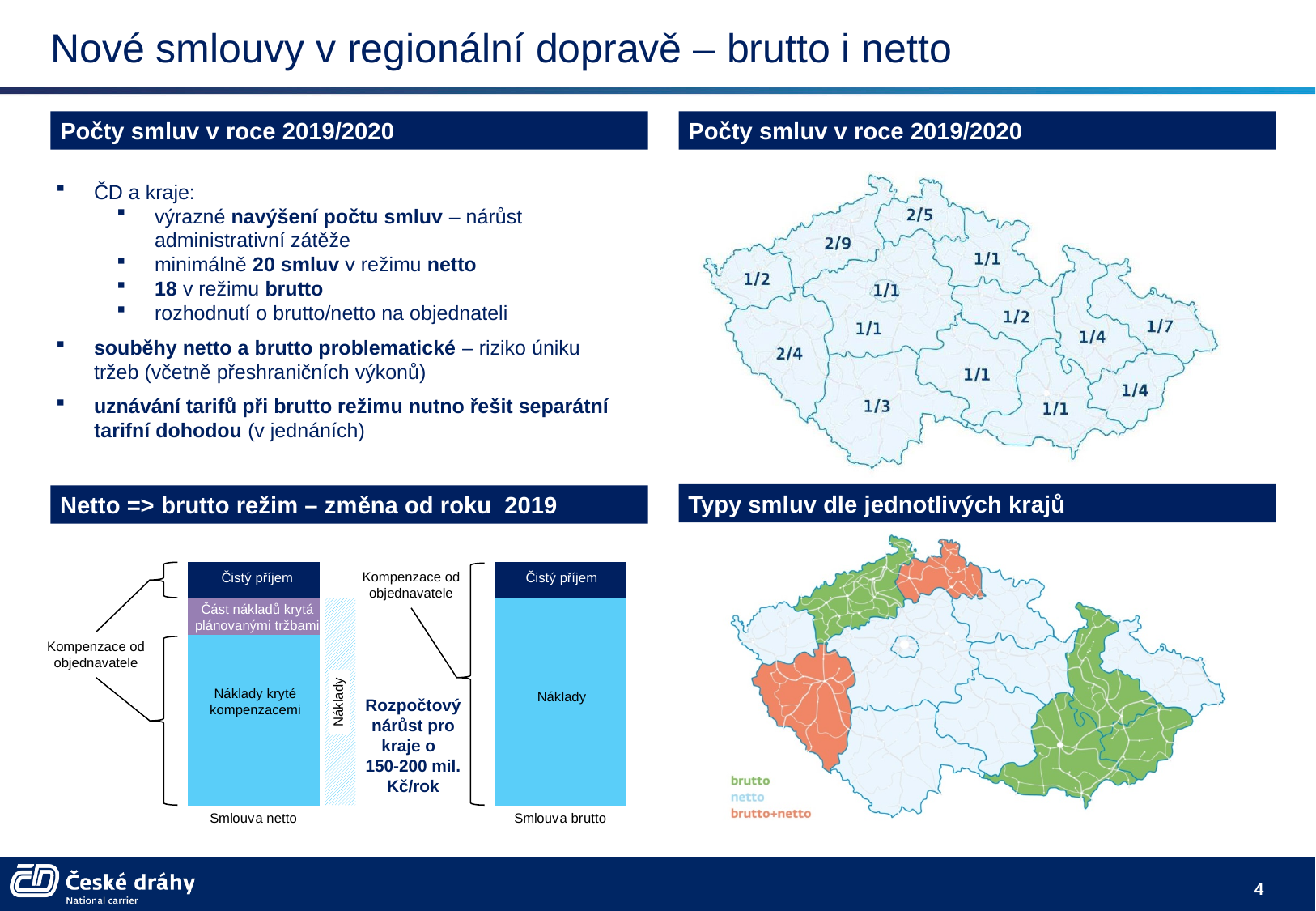
In the chart titled "Netto => brutto režim – změna od roku 2019", how many bars (contract types) are shown? 2 In the chart titled "Netto => brutto režim – změna od roku 2019", which segment appears in the "Smlouva netto" bar but not in the "Smlouva brutto" bar? Část nákladů krytá plánovanými tržbami In the chart titled "Netto => brutto režim – změna od roku 2019", what is the label of the top segment of both bars? Čistý příjem In the chart titled "Netto => brutto režim – změna od roku 2019", what are the labels of the two bars? Smlouva netto, Smlouva brutto In the chart titled "Netto => brutto režim – změna od roku 2019", how many segments make up the "Smlouva brutto" bar? 2 In the chart titled "Netto => brutto režim – změna od roku 2019", what budget increase for the regions is stated between the two bars? 150-200 mil. Kč/rok In the map titled "Typy smluv dle jednotlivých krajů", how many categories does the legend list? 3 In the map titled "Typy smluv dle jednotlivých krajů", which legend category is shown in green? brutto In the chart titled "Netto => brutto režim – změna od roku 2019", what kind of chart is used to compare the two contract types? Stacked bar chart In the chart titled "Netto => brutto režim – změna od roku 2019", what colour is the "Část nákladů krytá plánovanými tržbami" segment? Purple